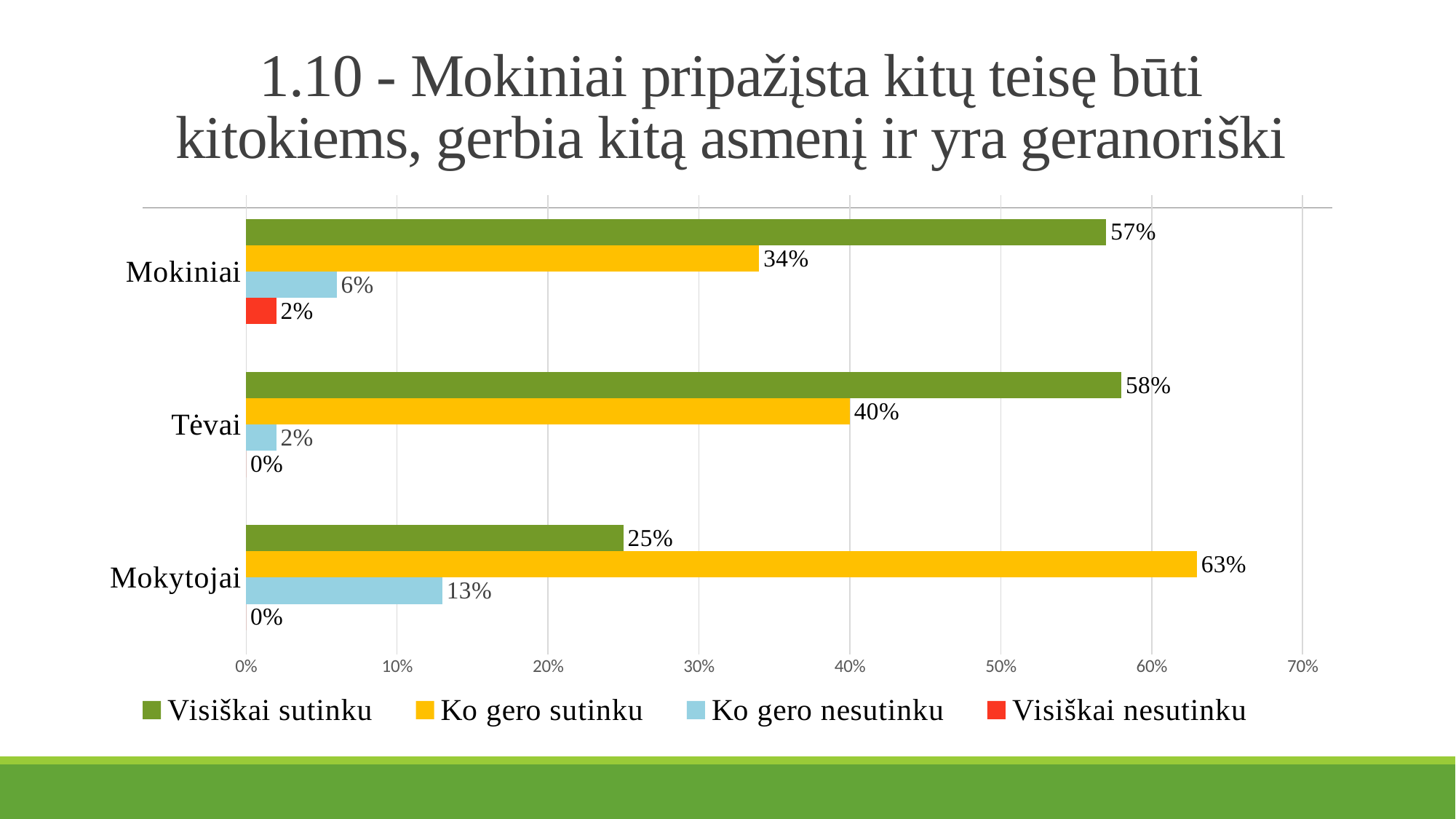
How many series does the legend list? 4 Which category has the highest value for "Ko gero sutinku"? Mokytojai What is the difference between the "Ko gero sutinku" values for Tėvai and Mokiniai? 6% How many categories are shown on the y axis? 3 Which category has the lowest value for "Visiškai sutinku"? Mokytojai What is the value for "Visiškai sutinku" in the Mokiniai category? 57% What is the value for "Visiškai nesutinku" in the Mokiniai category? 2% Which colour represents the "Visiškai nesutinku" series? Red Which is larger: the "Ko gero nesutinku" value for Mokytojai or for Mokiniai? Mokytojai What is the value for "Ko gero nesutinku" in the Tėvai category? 2% What is the value for "Ko gero sutinku" in the Mokytojai category? 63% What kind of chart is shown on the slide? Bar chart